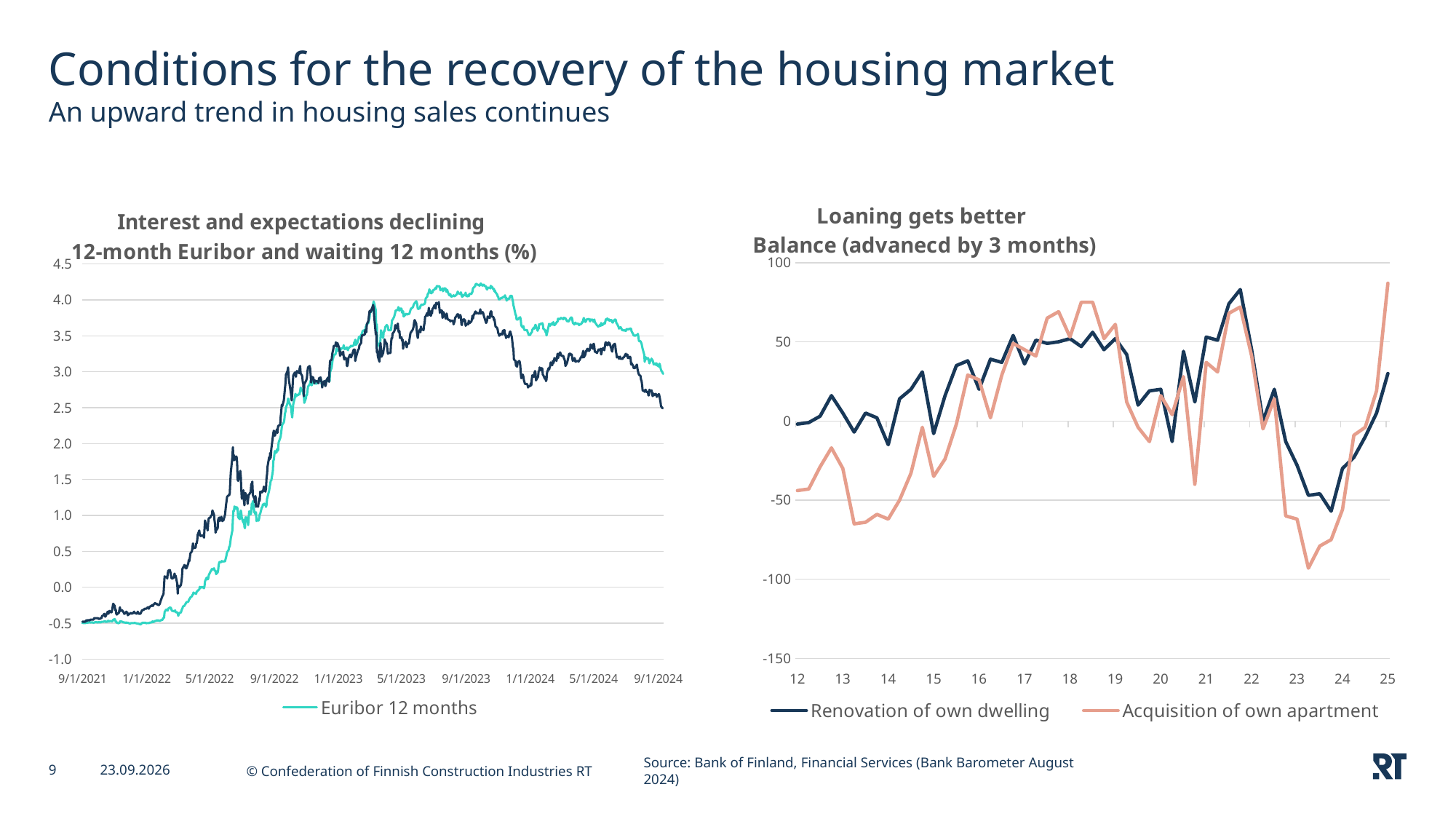
What kind of chart is the chart titled 'Interest and expectations declining'? line chart In the chart titled 'Interest and expectations declining', is the value of Euribor 12 months at 9/1/2023 greater or less than 4.0? greater In the chart titled 'Loaning gets better', is the value for Acquisition of own apartment at 12 greater or less than 0? less In the chart titled 'Loaning gets better', how many series does the legend list? 2 What kind of chart is the chart titled 'Loaning gets better'? line chart In the chart titled 'Loaning gets better', does the Acquisition of own apartment line rise or fall between 23 and 25? rise In the chart titled 'Interest and expectations declining', does the Euribor 12 months line rise or fall between 9/1/2021 and 9/1/2023? rise In the chart titled 'Interest and expectations declining', how many series does the legend list? 1 In the chart titled 'Interest and expectations declining', is the value of Euribor 12 months at 9/1/2021 greater or less than 0.0? less In the chart titled 'Loaning gets better', which series is drawn in the salmon/orange colour? Acquisition of own apartment